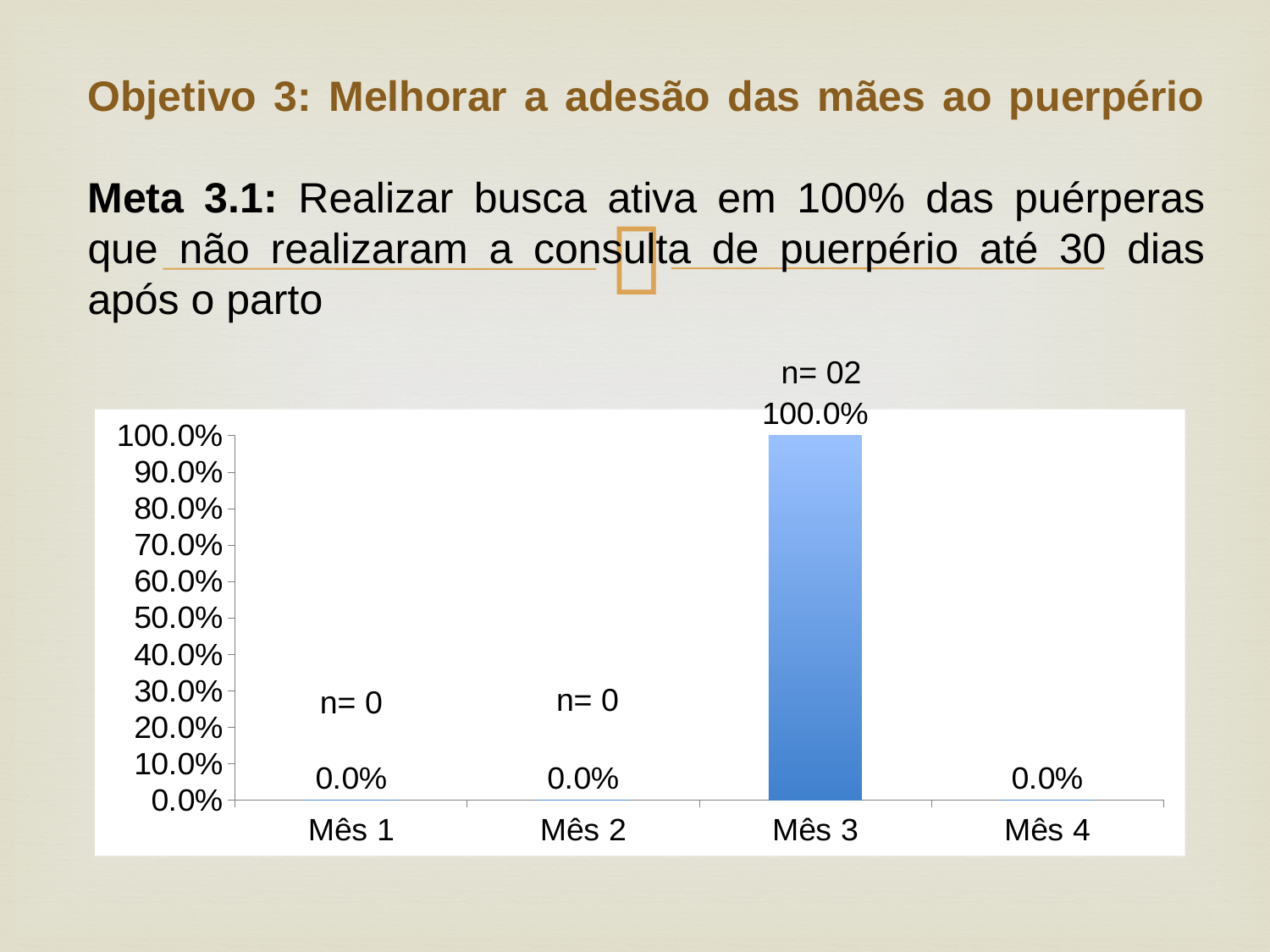
What is the n value annotated for Mês 1? n= 0 What is the highest tick value shown on the y axis? 100.0% What is the value for Mês 3? 100.0% Which month has the highest value? Mês 3 What kind of chart is shown on the slide? bar chart How many categories are shown on the x axis? 4 Is the value for Mês 3 greater or less than 50.0%? greater What is the difference between the values for Mês 3 and Mês 2? 100.0% Which is larger, the value for Mês 3 or the value for Mês 4? Mês 3 What is the value for Mês 4? 0.0% What is the value for Mês 1? 0.0% What is the n value annotated above the bar for Mês 3? n= 02